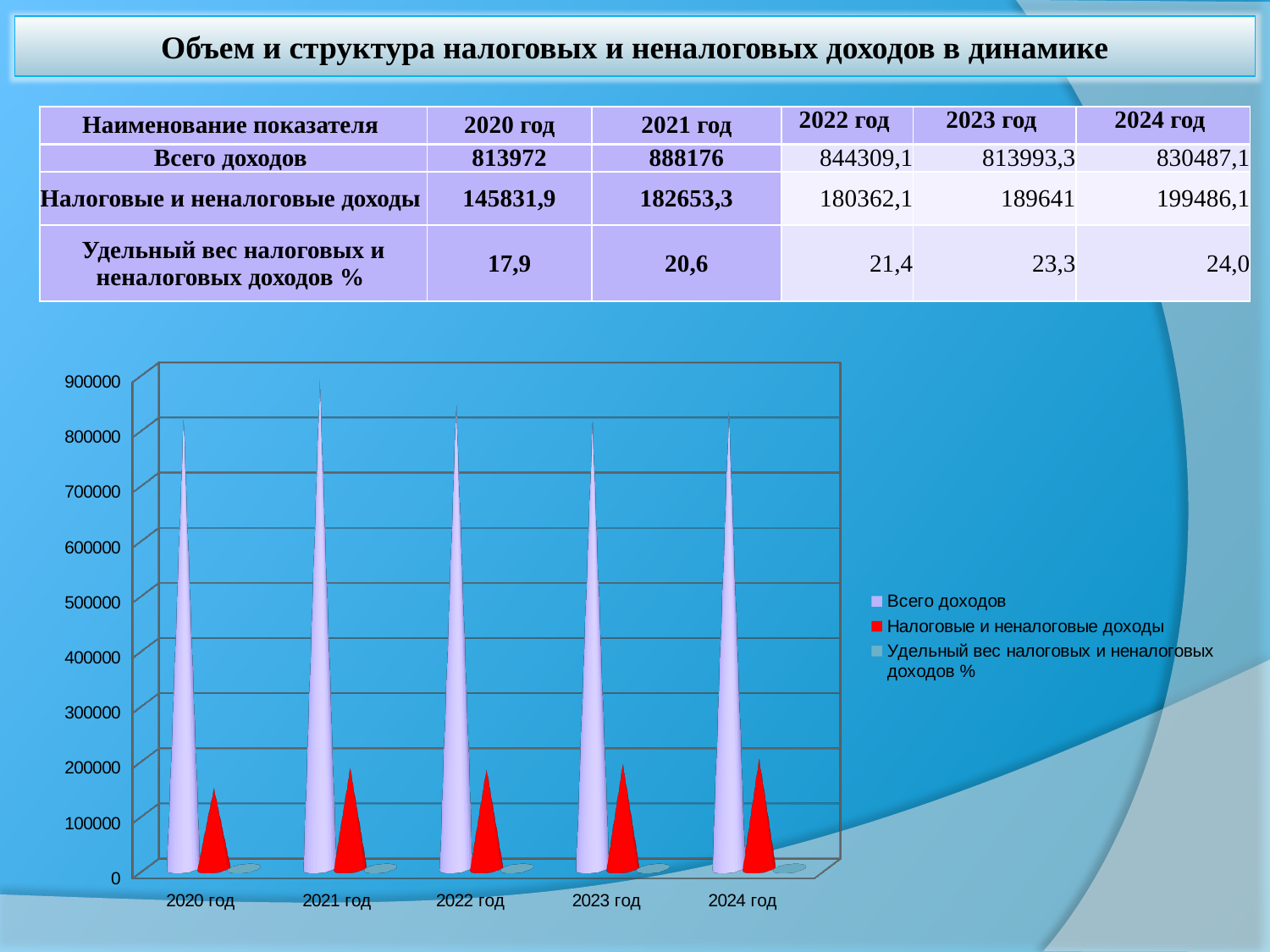
What colour represents Налоговые и неналоговые доходы in the chart? red Which is larger for Налоговые и неналоговые доходы: 2022 год or 2023 год? 2023 год How many series does the chart legend list? 3 What is the difference between Всего доходов in 2021 год and 2020 год? 74204 Is the value of Всего доходов for 2020 год greater or less than 900000? less What is the value of Всего доходов for 2021 год? 888176 What is the value of Налоговые и неналоговые доходы for 2024 год? 199486,1 How many years (categories) are shown along the x axis of the chart? 5 In which year is Налоговые и неналоговые доходы the lowest? 2020 год What kind of chart is shown on the slide? bar chart Does Удельный вес налоговых и неналоговых доходов % rise or fall from 2020 год to 2024 год? rise In which year is Всего доходов the highest? 2021 год